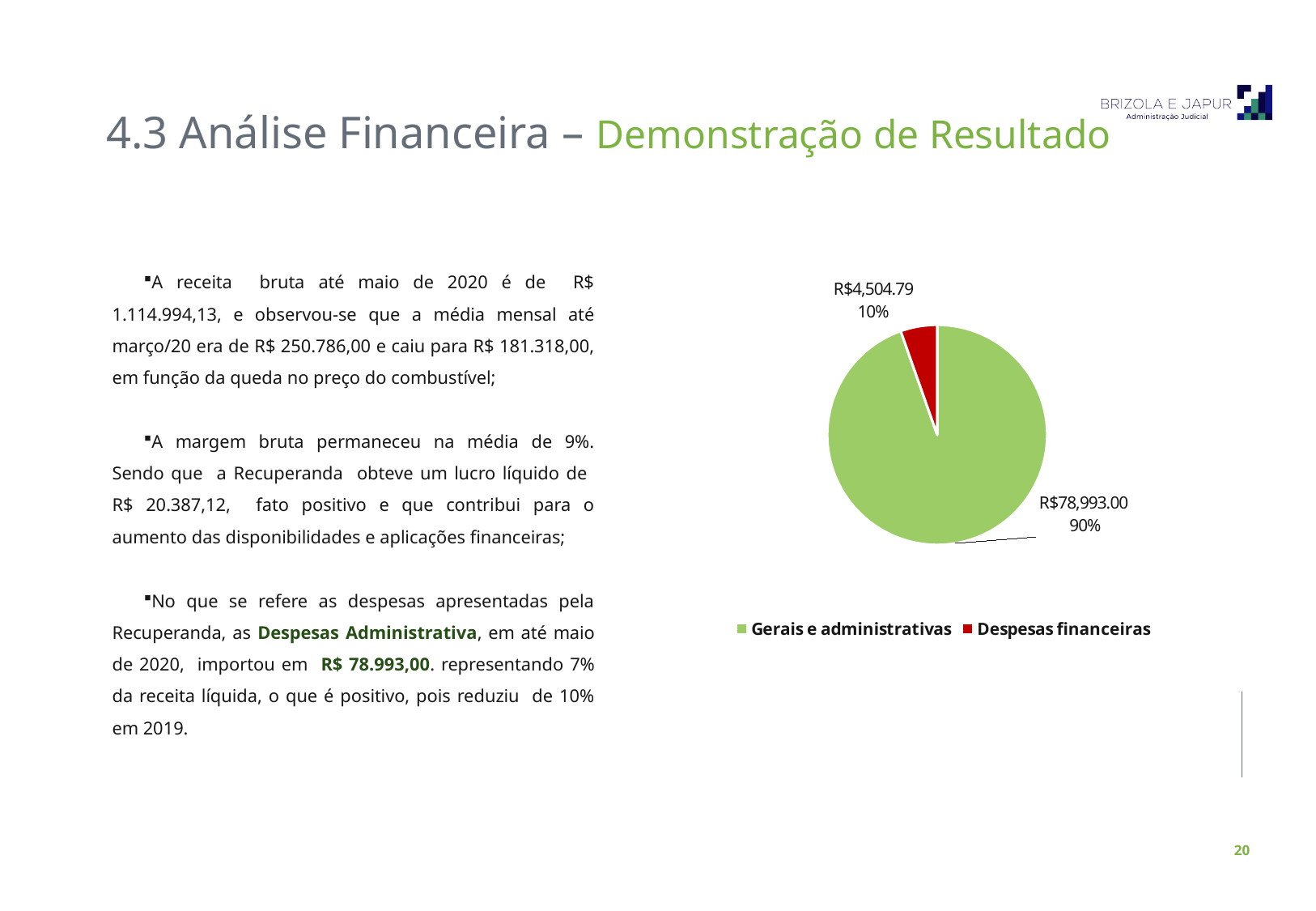
Which slice of the pie chart is the smallest? Despesas financeiras Which is larger in the pie chart, Gerais e administrativas or Despesas financeiras? Gerais e administrativas What is the value shown for Gerais e administrativas in the pie chart? R$78,993.00 How many slices does the pie chart have? 2 What share of the pie does Gerais e administrativas represent? 90% What is the value shown for Despesas financeiras in the pie chart? R$4,504.79 What is the difference between the values for Gerais e administrativas and Despesas financeiras? R$74,488.21 Which slice of the pie chart is the largest? Gerais e administrativas How many entries does the legend of the pie chart list? 2 What kind of chart is shown on the slide? pie chart What colour is the Despesas financeiras slice in the pie chart? red What share of the pie does Despesas financeiras represent? 10%